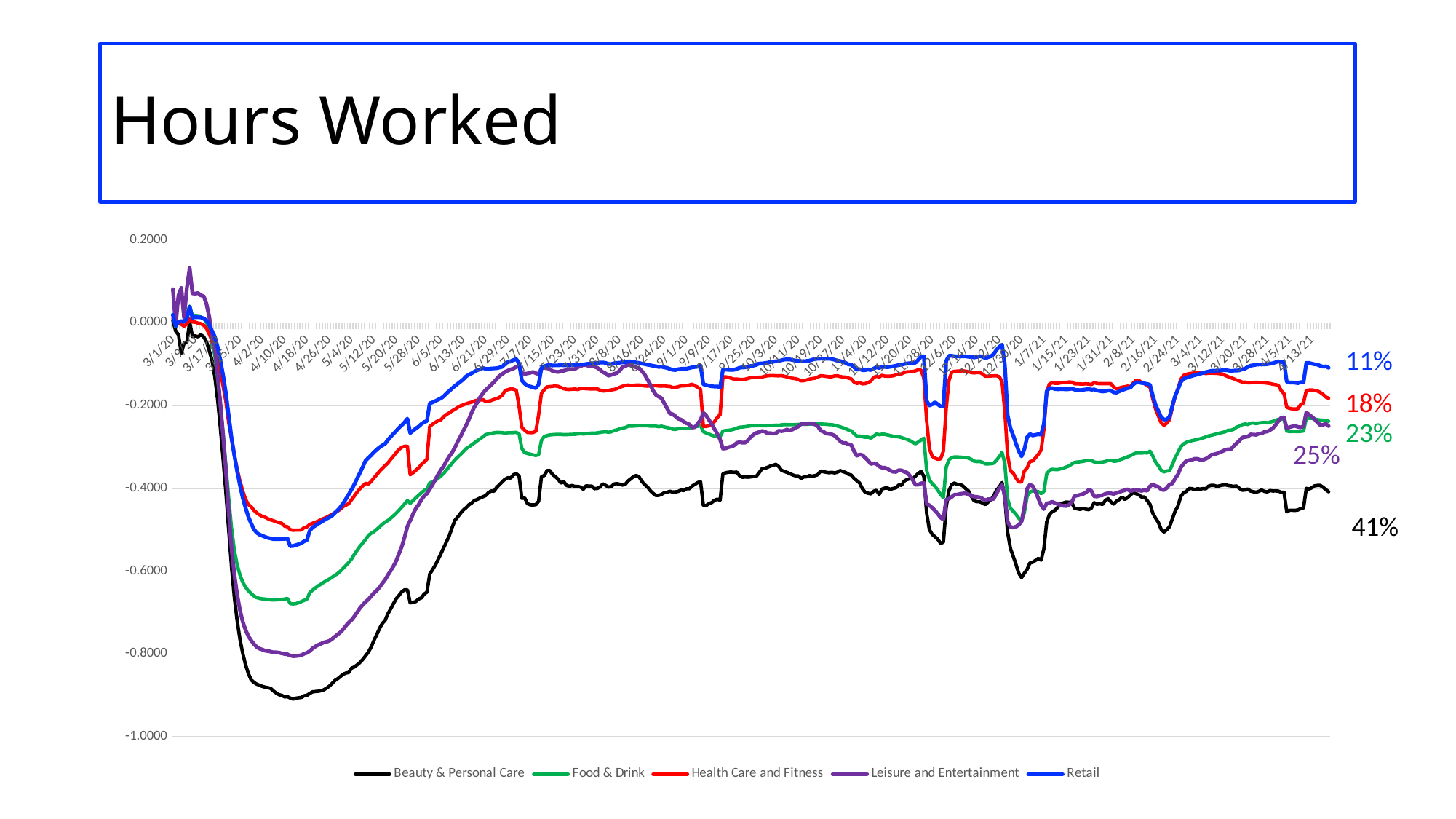
What is the title of the slide containing the chart? Hours Worked What percentage is annotated at the right edge of the chart next to the Leisure and Entertainment (purple) line? 25% Is the lowest value reached by the Beauty & Personal Care line greater or less than -0.8000? less What percentage is annotated at the right edge of the chart next to the Beauty & Personal Care (black) line? 41% What percentage is annotated at the right edge of the chart next to the Retail (blue) line? 11% Is the lowest value reached by the Food & Drink line greater or less than -0.6000? less What kind of chart is shown on the slide? line chart Which series drops to the lowest value on the chart? Beauty & Personal Care What colour is the Retail line in the chart? blue How many series does the legend list? 5 Between 4/10/20 and 6/21/20, do the lines generally rise or fall? rise What percentage is annotated at the right edge of the chart next to the Food & Drink (green) line? 23%